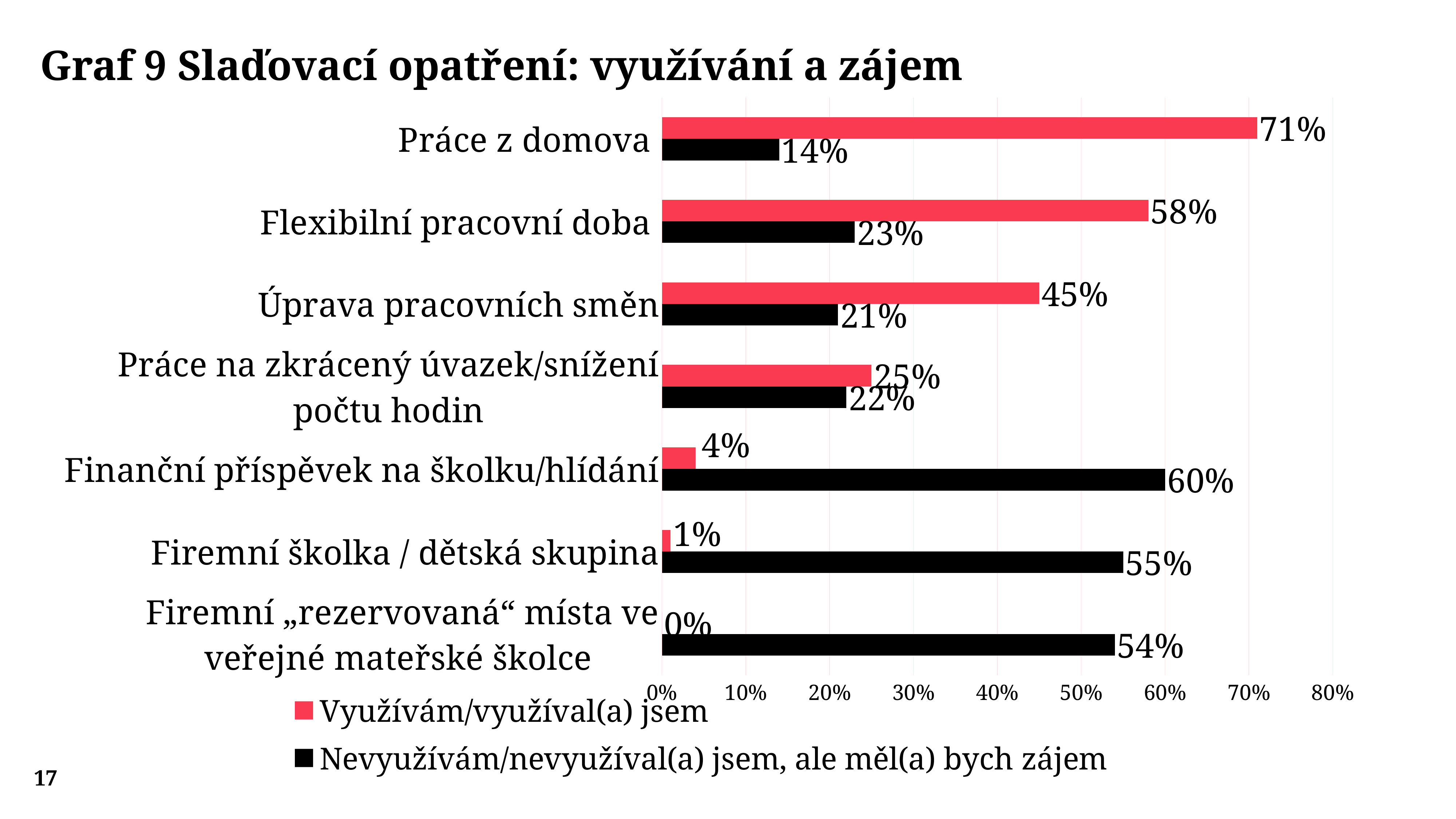
What is the value for "Práce z domova" in the "Využívám/využíval(a) jsem" series? 71% What is the value for "Finanční příspěvek na školku/hlídání" in the "Nevyužívám/nevyužíval(a) jsem, ale měl(a) bych zájem" series? 60% Which category has the lowest value in the "Využívám/využíval(a) jsem" series? Firemní „rezervovaná“ místa ve veřejné mateřské školce Which category has the highest value in the "Využívám/využíval(a) jsem" series? Práce z domova What kind of chart is shown on the slide? Bar chart What colour represents the "Využívám/využíval(a) jsem" series? Red What is the difference between the "Využívám/využíval(a) jsem" and "Nevyužívám/nevyužíval(a) jsem, ale měl(a) bych zájem" values for "Práce z domova"? 57% How many series does the legend list? 2 What is the value for "Flexibilní pracovní doba" in the "Nevyužívám/nevyužíval(a) jsem, ale měl(a) bych zájem" series? 23% Which category has the lowest value in the "Nevyužívám/nevyužíval(a) jsem, ale měl(a) bych zájem" series? Práce z domova Which is larger for "Úprava pracovních směn": the "Využívám/využíval(a) jsem" value or the "Nevyužívám/nevyužíval(a) jsem, ale měl(a) bych zájem" value? Využívám/využíval(a) jsem How many categories are shown on the chart? 7